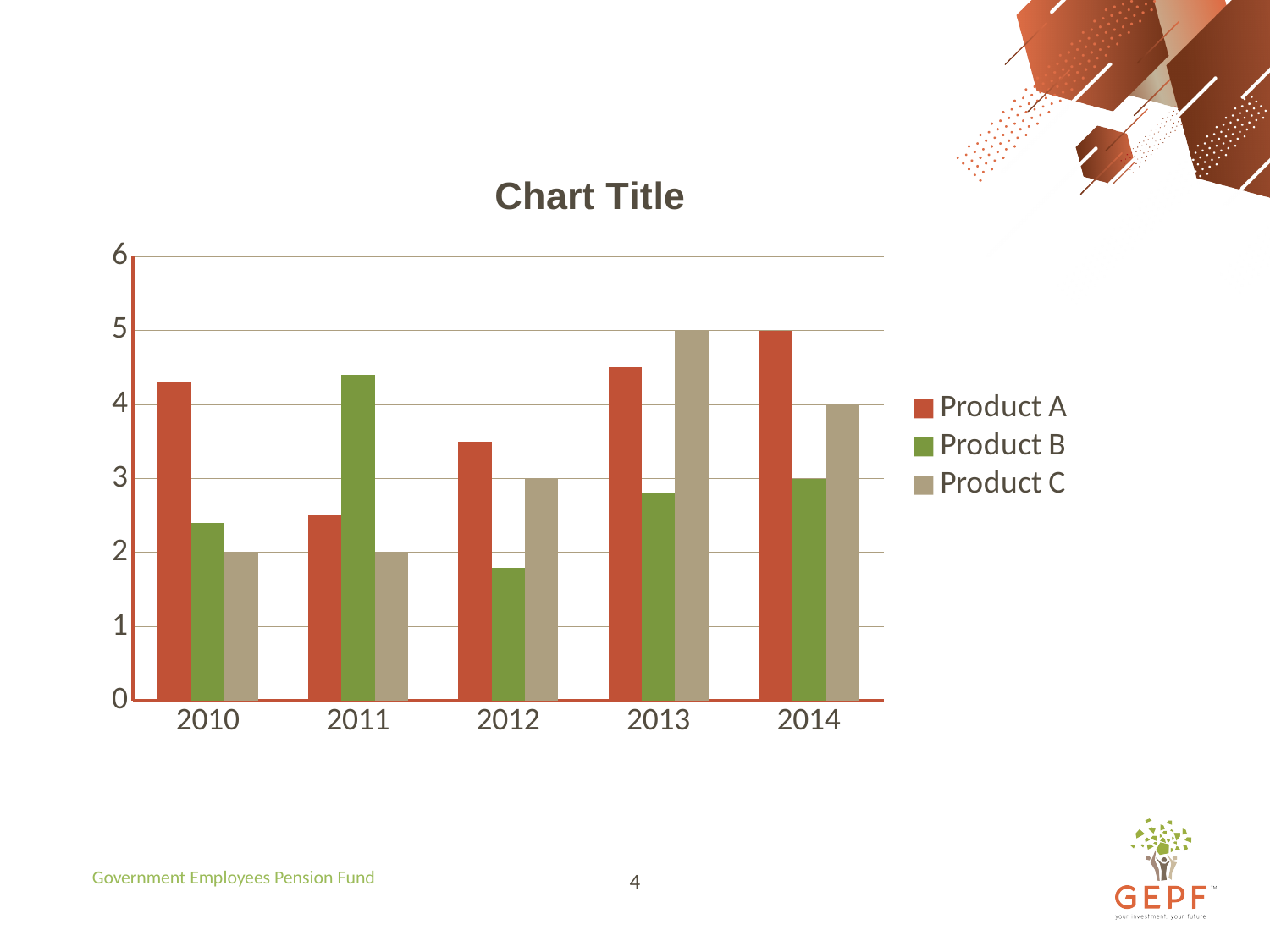
Is the value for Product A in 2010 greater or less than 4? greater How many series does the legend list? 3 What kind of chart is shown on the slide? bar chart What is the difference between Product C in 2013 and Product C in 2010? 3 Is the value for Product B in 2012 greater or less than 2? less In 2011, which is larger, Product A or Product B? Product B In which year is Product B lowest? 2012 How many years are shown on the x axis? 5 What is the value for Product C in 2010? 2 What is the value for Product A in 2014? 5 In which year is Product C highest? 2013 What is the value for Product C in 2013? 5